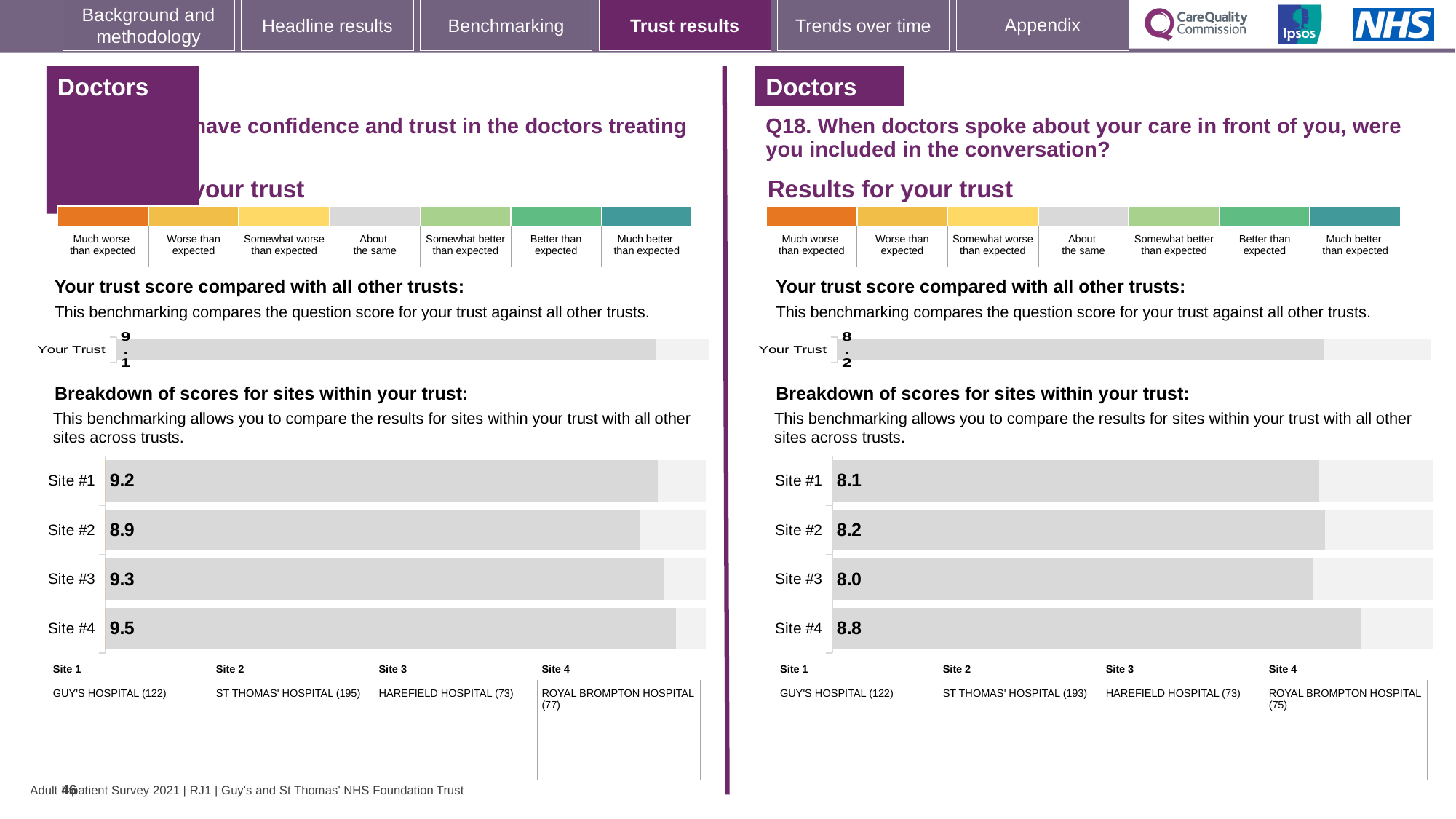
What kind of chart is the right-hand (Q18) 'Breakdown of scores for sites within your trust' chart? Bar chart How many sites are shown on the left-hand 'Breakdown of scores for sites within your trust' chart? 4 On the left-hand 'Your trust score compared with all other trusts' chart, what is the score shown for Your Trust? 9.1 On the left-hand 'Breakdown of scores for sites within your trust' chart, what is the difference between the scores for Site #4 and Site #2? 0.6 On the left-hand 'Breakdown of scores for sites within your trust' chart, which site has the lowest score? Site #2 On the right-hand (Q18) 'Your trust score compared with all other trusts' chart, what is the score shown for Your Trust? 8.2 On the right-hand (Q18) 'Breakdown of scores for sites within your trust' chart, which site has the highest score? Site #4 On the right-hand (Q18) 'Breakdown of scores for sites within your trust' chart, which is larger: the score for Site #2 or Site #3? Site #2 On the left-hand 'Breakdown of scores for sites within your trust' chart, what is the score for Site #4? 9.5 On the right-hand (Q18) 'Breakdown of scores for sites within your trust' chart, what is the score for Site #3? 8.0 On the right-hand (Q18) 'Breakdown of scores for sites within your trust' chart, what is the difference between the scores for Site #4 and Site #1? 0.7 On the left-hand 'Breakdown of scores for sites within your trust' chart, which is larger: the score for Site #1 or Site #3? Site #3